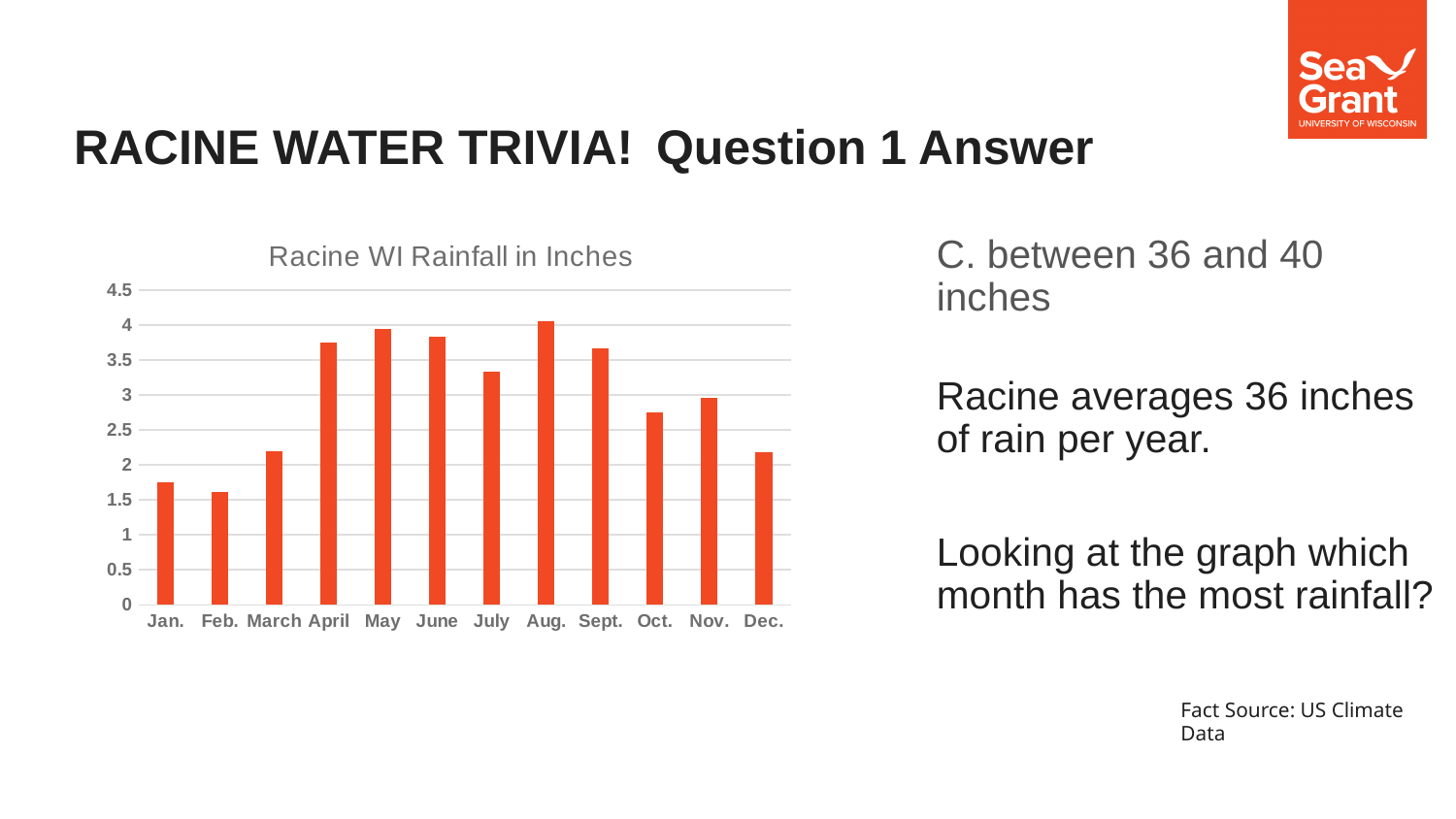
Does rainfall rise or fall from Jan. to May? rise Which month has the lowest rainfall on the chart? Feb. How many months are plotted on the chart? 12 Which month has more rainfall, Jan. or Nov.? Nov. What is the title of the chart? Racine WI Rainfall in Inches Which month has the highest rainfall on the chart? Aug. What kind of chart is shown on the slide? bar chart Is the rainfall value for Oct. greater or less than 3? less Which month has more rainfall, April or Oct.? April Is the rainfall value for Jan. greater or less than 2? less Is the rainfall value for April greater or less than 3.5? greater